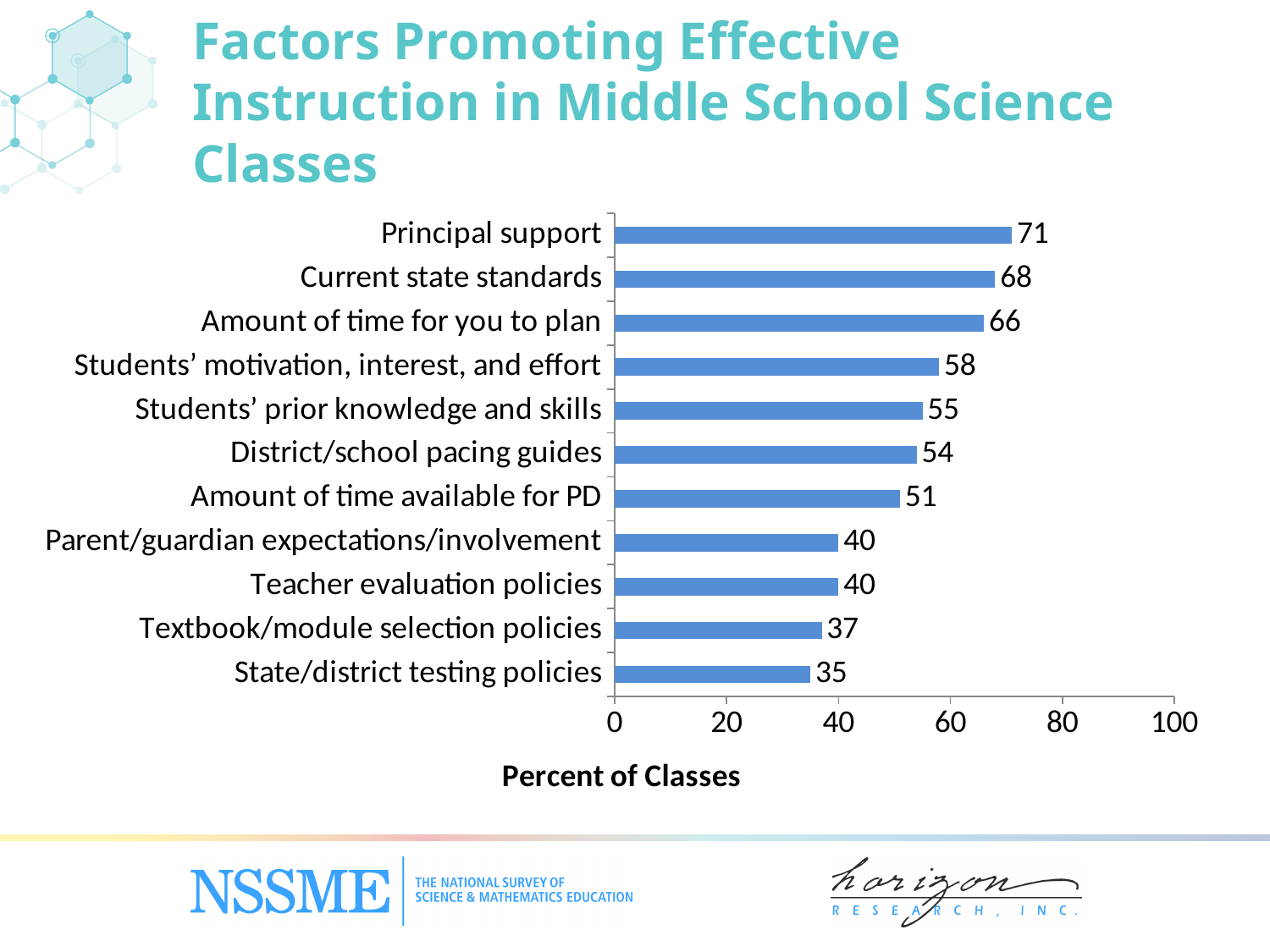
What is the difference between the values for Students' motivation, interest, and effort and Teacher evaluation policies? 18 Which factor has the lowest percent of classes? State/district testing policies Is the value for Amount of time for you to plan greater or less than 60? greater Which factor has the highest percent of classes? Principal support What percent of classes is shown for Principal support? 71 What is the value for State/district testing policies? 35 Which is larger: the value for Students' prior knowledge and skills or the value for Textbook/module selection policies? Students' prior knowledge and skills What is the difference between the values for Current state standards and Amount of time available for PD? 17 What kind of chart is shown on the slide? Bar chart What is the value for District/school pacing guides? 54 What is the label of the horizontal axis? Percent of Classes How many factors are plotted in the chart? 11